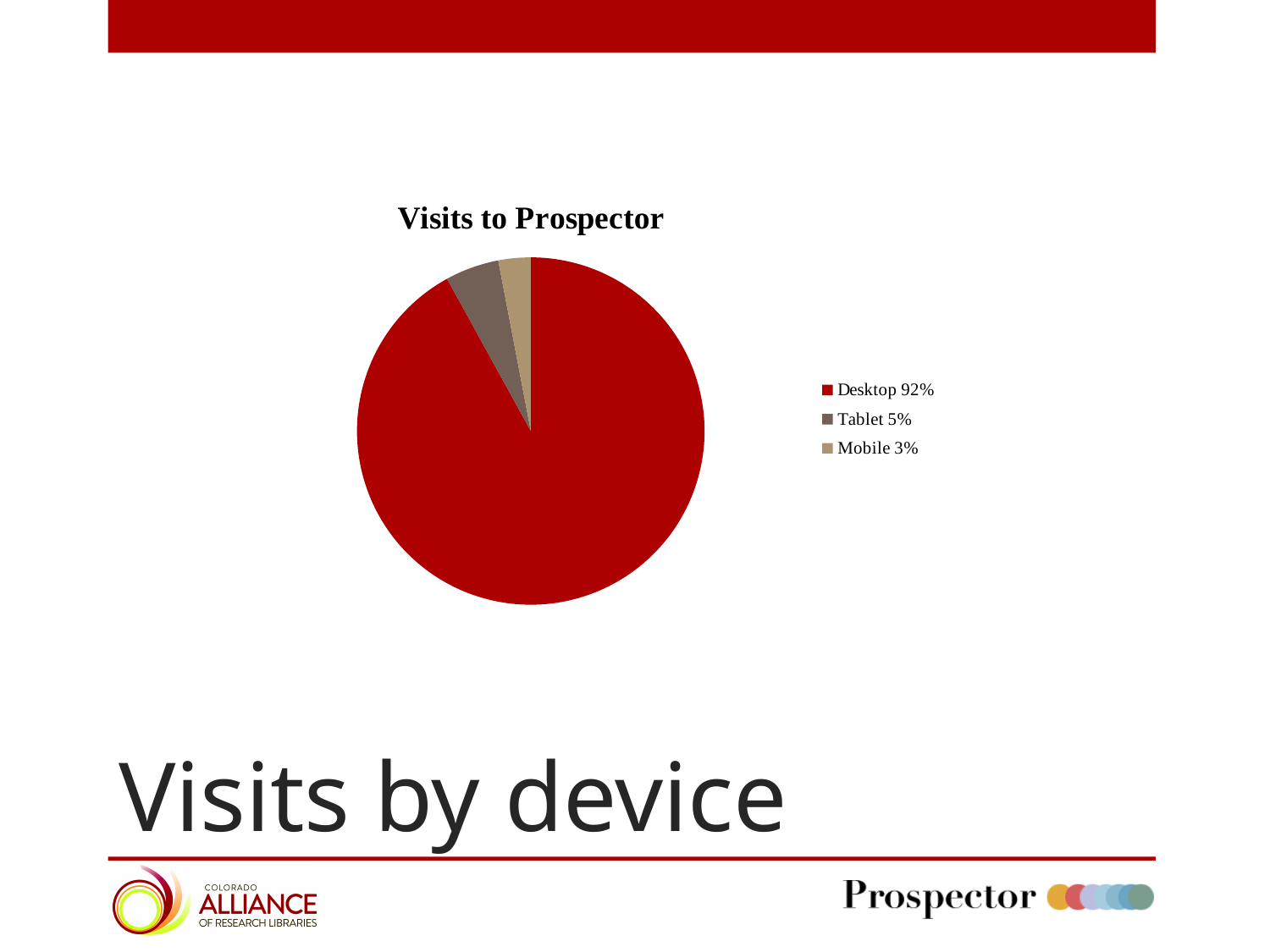
What share of visits to Prospector comes from Desktop? 92% Which device category has the smallest share of visits? Mobile What is the difference in percentage points between the Desktop and Tablet shares? 87 What is the difference in percentage points between the Tablet and Mobile shares? 2 Which colour represents Desktop in the pie chart? red What share of visits to Prospector comes from Tablet? 5% How many device categories does the pie chart show? 3 What kind of chart is shown on the slide? pie chart What share of visits to Prospector comes from Mobile? 3% Which device category has the largest share of visits? Desktop Which has a larger share of visits, Tablet or Mobile? Tablet What is the title of the chart? Visits to Prospector